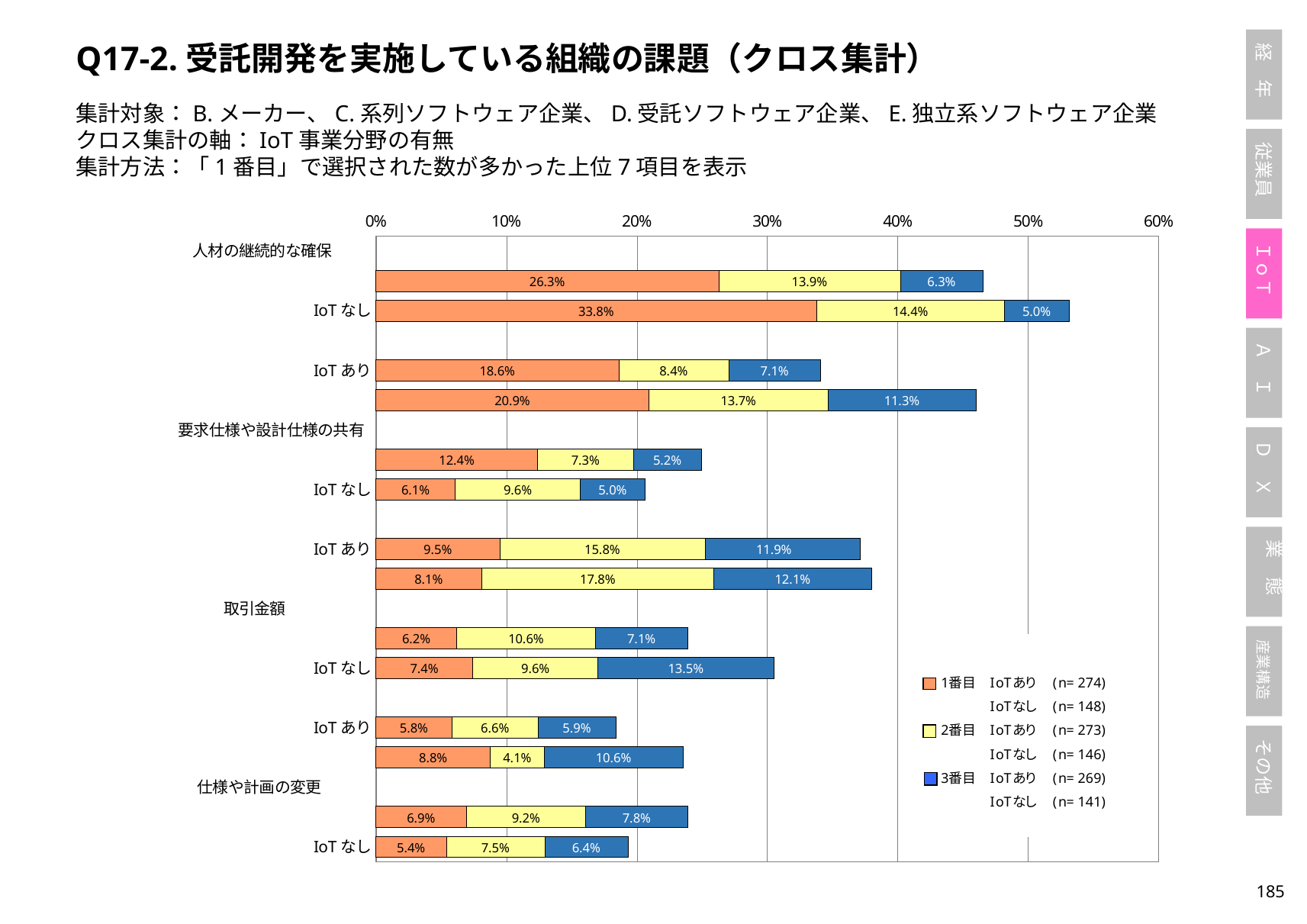
In the topmost bar, what is the difference between the 1番目 segment (26.3%) and the 2番目 segment (13.9%)? 12.4% Which bar has the largest 1番目 (orange) segment value? The IoT なし bar below 人材の継続的な確保 (33.8%) What is the total of the topmost bar (26.3%, 13.9%, 6.3%)? 46.5% What kind of chart is shown on the slide? bar chart In the bottom bar labelled "IoT なし", what is the value of the 2番目 (yellow) segment? 7.5% What is the total of the bar labelled "IoT なし" directly below "人材の継続的な確保" (33.8%, 14.4%, 5.0%)? 53.2% According to the legend, what is the n for 1番目 IoT あり? n= 274 Which is larger: the 2番目 segment of 17.8% or the 2番目 segment of 15.8%? 17.8% How many series does the chart legend list? 3 What is the smallest 2番目 (yellow) segment value shown in the chart? 4.1% In the bar whose 1番目 segment is 7.4%, what is the value of the 3番目 (blue) segment? 13.5% In the bar labelled "IoT なし" directly below "人材の継続的な確保", what is the value of the 1番目 (orange) segment? 33.8%